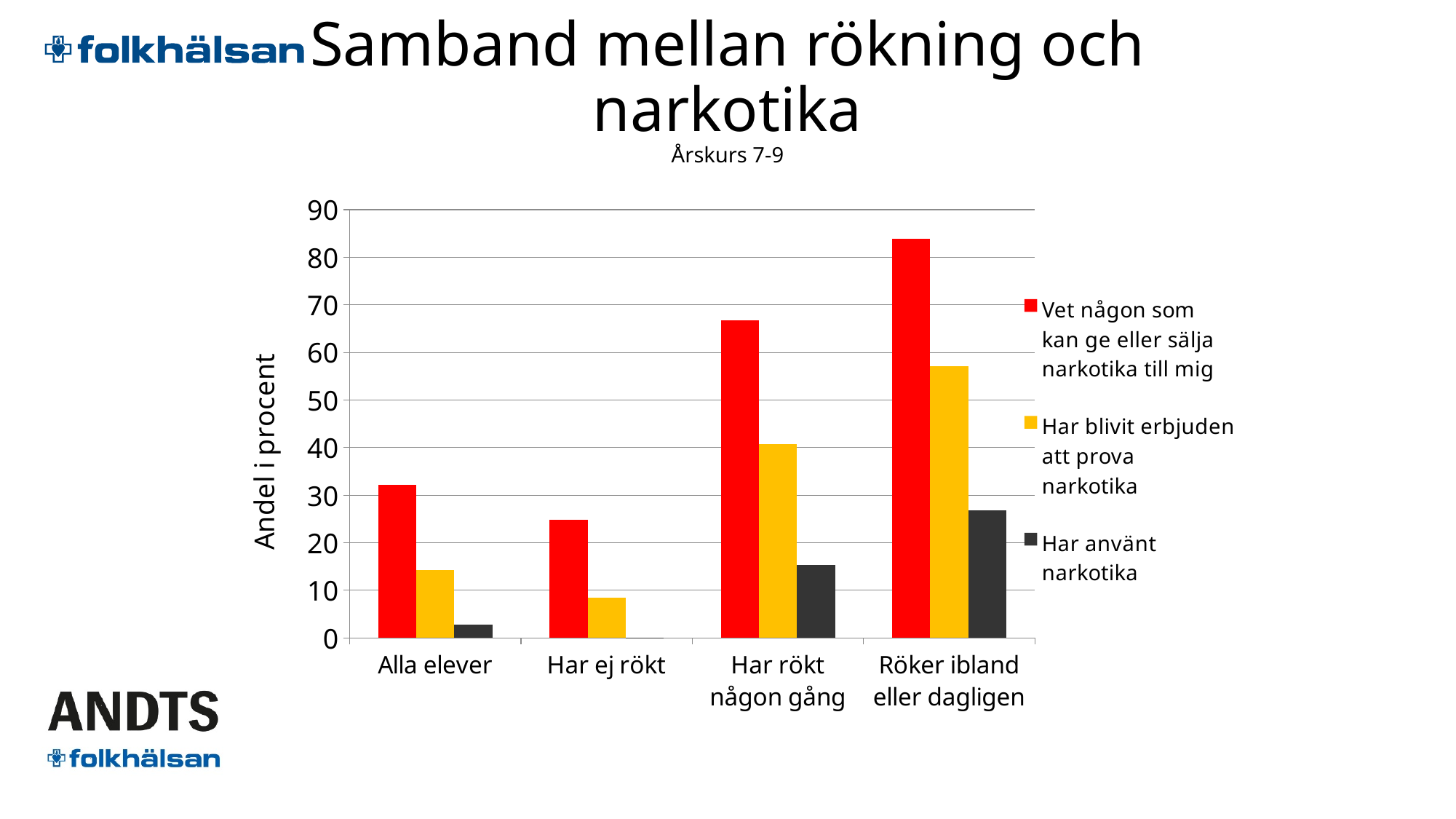
Which category has the lowest value for 'Har använt narkotika'? Har ej rökt Is the value for 'Vet någon som kan ge eller sälja narkotika till mig' in the 'Röker ibland eller dagligen' category greater or less than 80? greater Which category has the highest value for 'Vet någon som kan ge eller sälja narkotika till mig'? Röker ibland eller dagligen What kind of chart is shown on the slide? bar chart Is the value for 'Har använt narkotika' in the 'Har rökt någon gång' category greater or less than 10? greater Which is larger: 'Vet någon som kan ge eller sälja narkotika till mig' for 'Alla elever' or for 'Har ej rökt'? Alla elever What is the label of the y axis? Andel i procent Which is larger: 'Har blivit erbjuden att prova narkotika' for 'Har rökt någon gång' or for 'Röker ibland eller dagligen'? Röker ibland eller dagligen How many categories are shown on the x axis? 4 Is the value for 'Har blivit erbjuden att prova narkotika' in the 'Alla elever' category greater or less than 20? less Which colour represents the series 'Har använt narkotika'? dark grey How many series does the legend list? 3